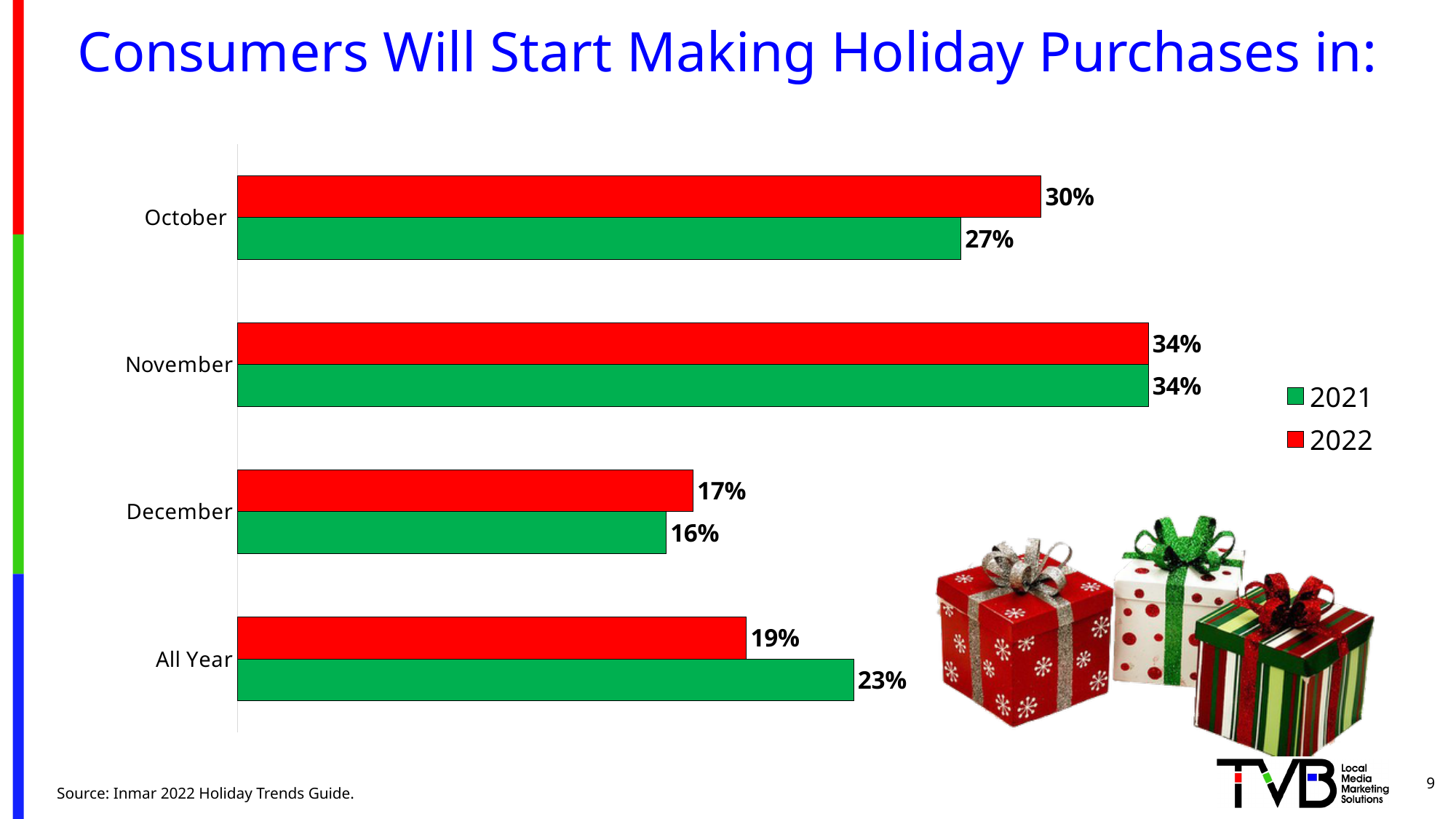
Which is larger for December, the 2021 value or the 2022 value? 2022 What is the 2021 value for December? 16% What is the difference between the 2021 and 2022 values for All Year? 4% What is the difference between the 2022 and 2021 values for October? 3% What kind of chart is shown on the slide? bar chart Which colour represents the 2021 series? green How many categories are shown on the chart? 4 What is the 2021 value for All Year? 23% What is the 2022 value for October? 30% Which category has the highest 2022 value? November How many series does the legend list? 2 Which category has the lowest 2021 value? December